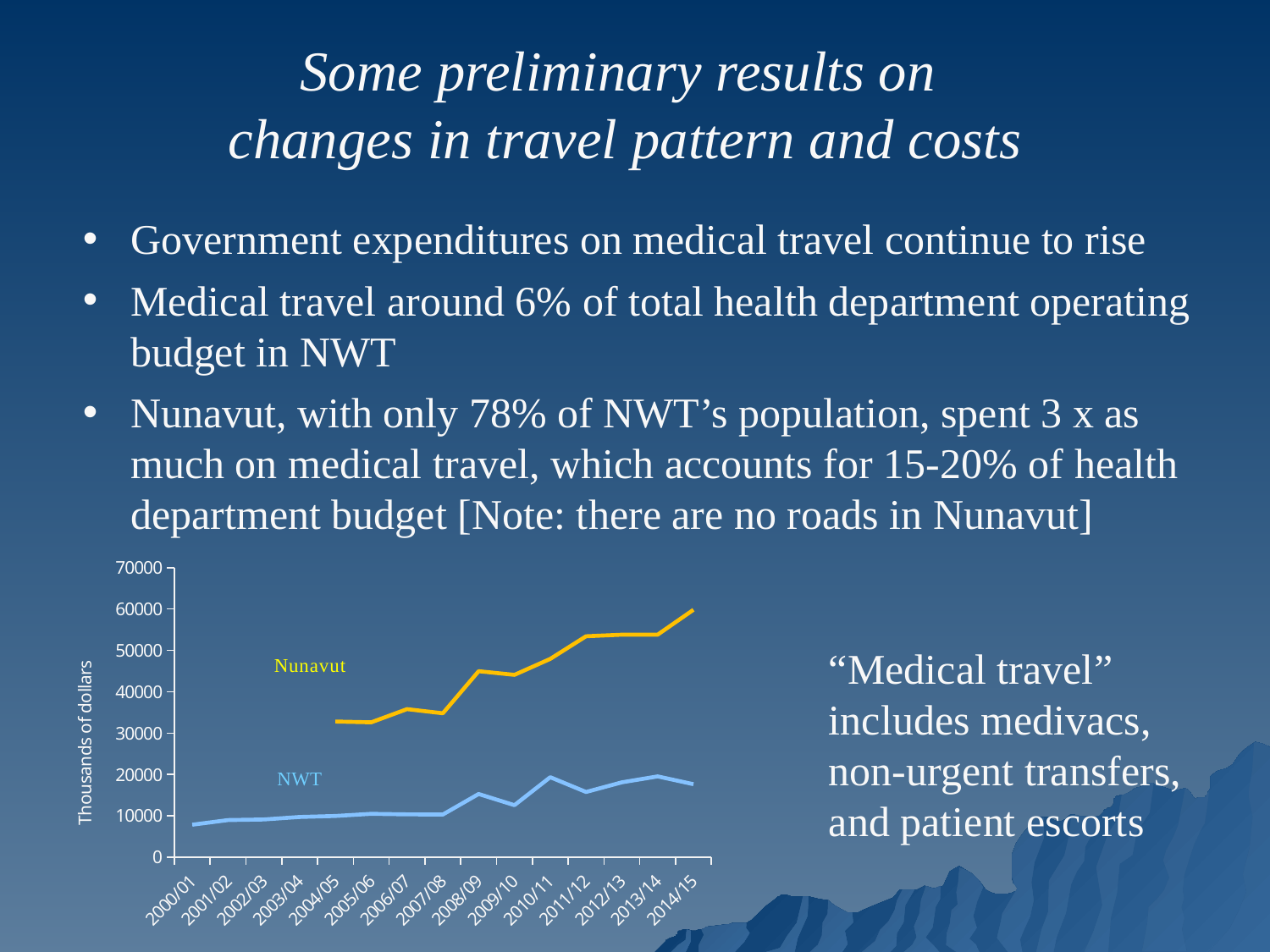
Is the value for Nunavut in 2004/05 greater or less than 40000? less What kind of chart is shown on the slide? line chart What is the label of the vertical axis of the chart? Thousands of dollars In 2010/11, which line has the higher value, Nunavut or NWT? Nunavut How many series (lines) are plotted on the chart? 2 How many fiscal years are shown along the x axis of the chart? 15 Is the value for Nunavut in 2008/09 greater or less than 40000? greater In which fiscal year does the Nunavut line reach its highest value? 2014/15 Is the value for Nunavut in 2014/15 greater or less than 50000? greater Which two regions are labelled on the lines in the chart? Nunavut and NWT Does the Nunavut line generally rise or fall from 2004/05 to 2014/15? rise